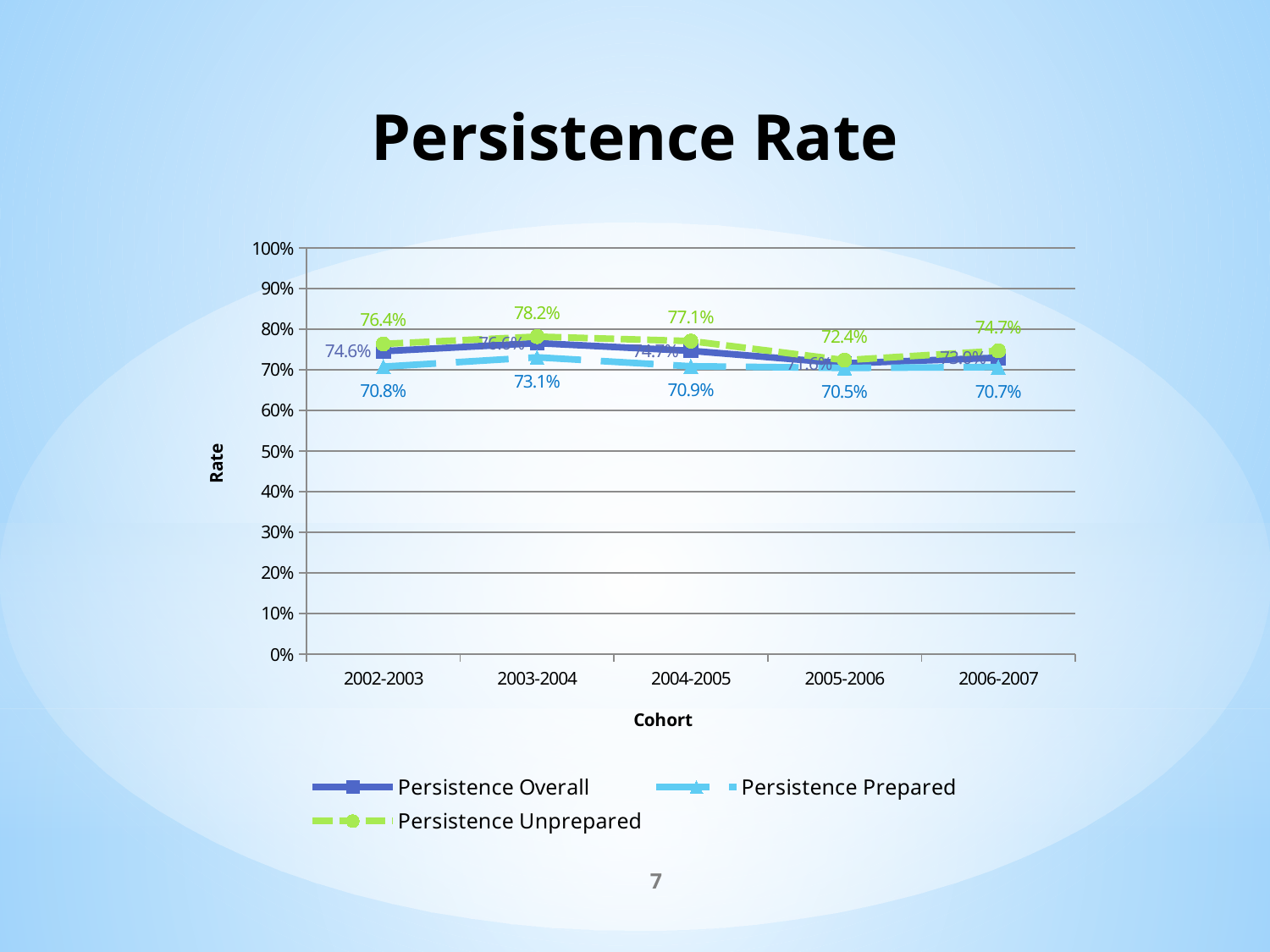
What is the Persistence Unprepared rate for the 2003-2004 cohort? 78.2% Is the Persistence Prepared value for the 2004-2005 cohort greater or less than 80%? less How many series does the legend list? 3 For the 2003-2004 cohort, how much higher is the Persistence Unprepared rate than the Persistence Prepared rate? 5.1 percentage points What kind of chart is shown on the slide? line chart Which cohort has a higher Persistence Unprepared rate, 2002-2003 or 2006-2007? 2002-2003 What is the Persistence Prepared rate for the 2005-2006 cohort? 70.5% Which cohort has the lowest Persistence Prepared rate? 2005-2006 How many cohorts are shown on the x axis? 5 Does the Persistence Unprepared rate rise or fall from the 2003-2004 cohort to the 2005-2006 cohort? fall What is the Persistence Overall rate for the 2002-2003 cohort? 74.6% Which cohort has the highest Persistence Unprepared rate? 2003-2004